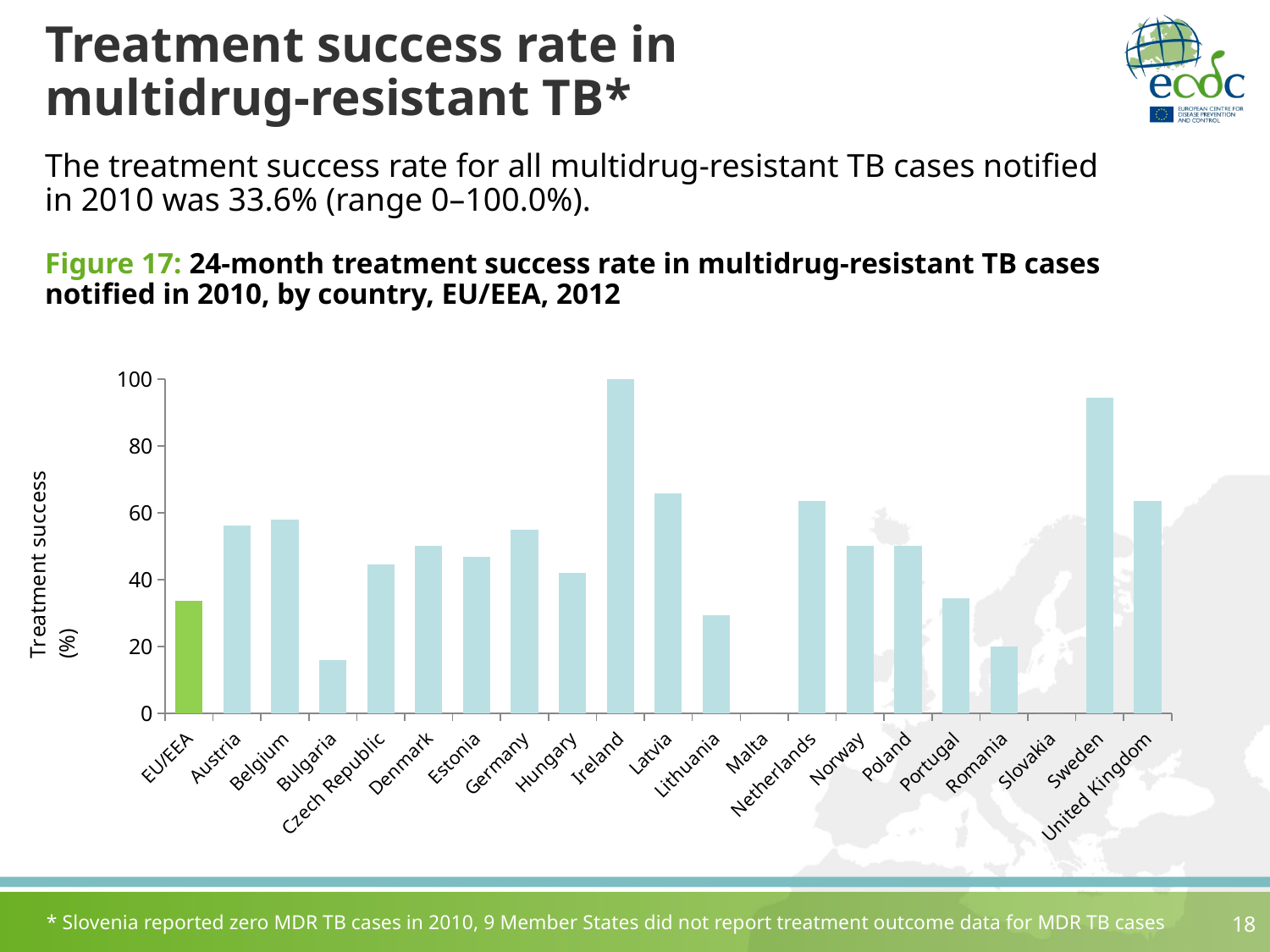
Is the value for Sweden greater or less than 80? greater Is the value for Bulgaria greater or less than 20? less How many countries/categories are listed along the x axis of the chart? 21 Which has a higher treatment success rate, Latvia or Lithuania? Latvia What is the treatment success rate for Ireland? 100 What is the treatment success rate for EU/EEA, as stated on the slide? 33.6% What kind of chart is shown in Figure 17? bar chart Is the value for Latvia greater or less than 60? greater Which country has the highest treatment success rate in the chart? Ireland What is the label on the y axis of the chart? Treatment success (%) Which has a higher treatment success rate, Ireland or Sweden? Ireland